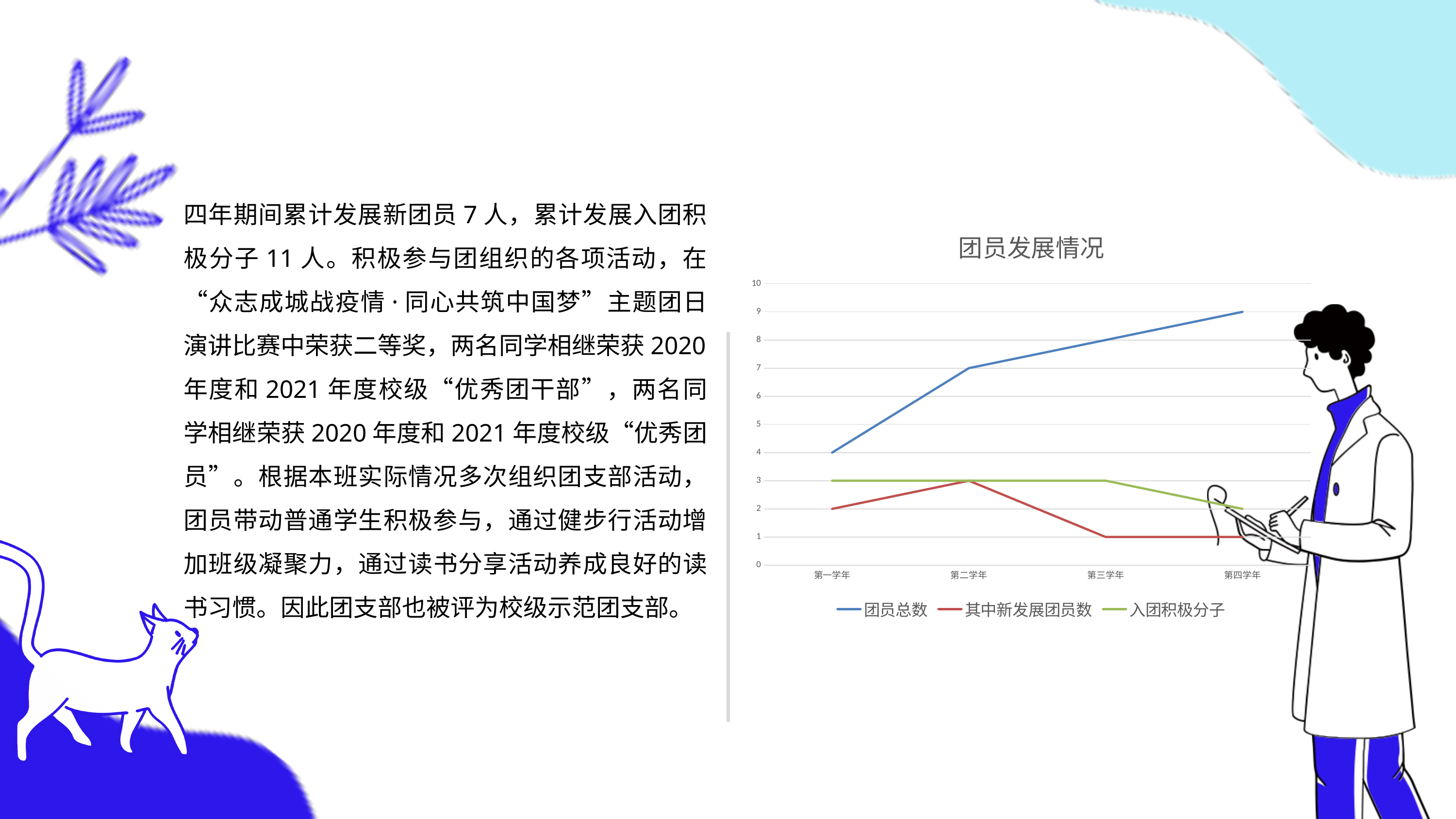
What kind of chart is shown on the slide? line chart What is the value of 其中新发展团员数 in 第二学年? 3 In which academic year is 团员总数 lowest? 第一学年 What is the title of the chart? 团员发展情况 What is the value of 入团积极分子 in 第四学年? 2 In which academic year is 团员总数 highest? 第四学年 What is the value of 团员总数 in 第四学年? 9 How many categories are shown on the x axis of the chart? 4 What is the value of 团员总数 in 第一学年? 4 How many series does the chart legend list? 3 Does 团员总数 rise or fall from 第一学年 to 第四学年? rise What is the difference between 团员总数 in 第四学年 and 第一学年? 5